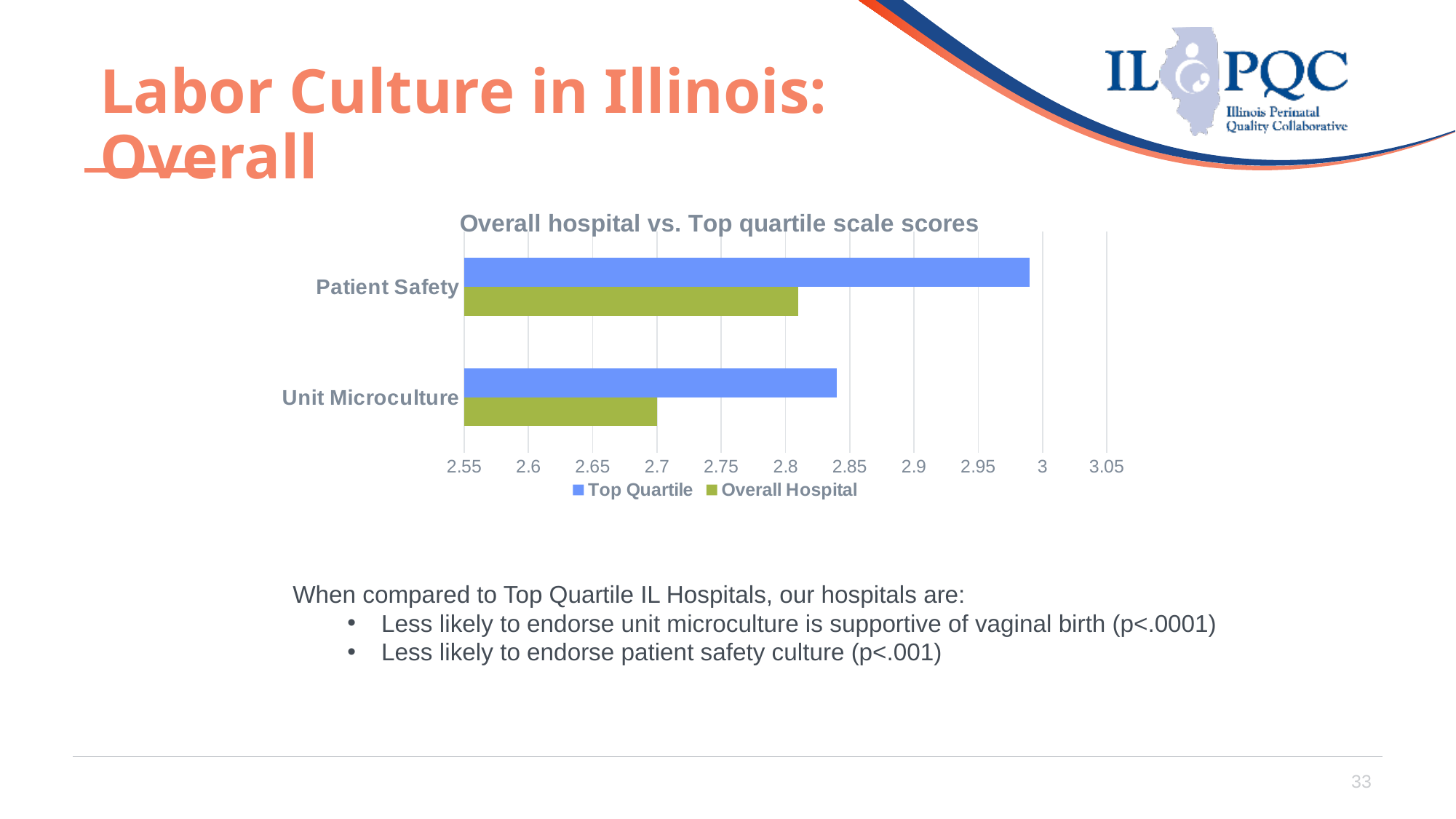
Is the Top Quartile value for Unit Microculture greater or less than 2.8? greater For Patient Safety, which series has the larger value: Top Quartile or Overall Hospital? Top Quartile How many categories are shown on the chart's vertical axis? 2 Is the Overall Hospital value for Unit Microculture greater or less than 2.75? less Which category has the higher Overall Hospital score: Patient Safety or Unit Microculture? Patient Safety Is the Top Quartile value for Patient Safety greater or less than 2.95? greater Which series is shown in blue in the chart? Top Quartile What is the title of the chart? Overall hospital vs. Top quartile scale scores How many series does the chart legend list? 2 Which bar in the chart is the longest? Top Quartile for Patient Safety What kind of chart is shown on the slide? Bar chart